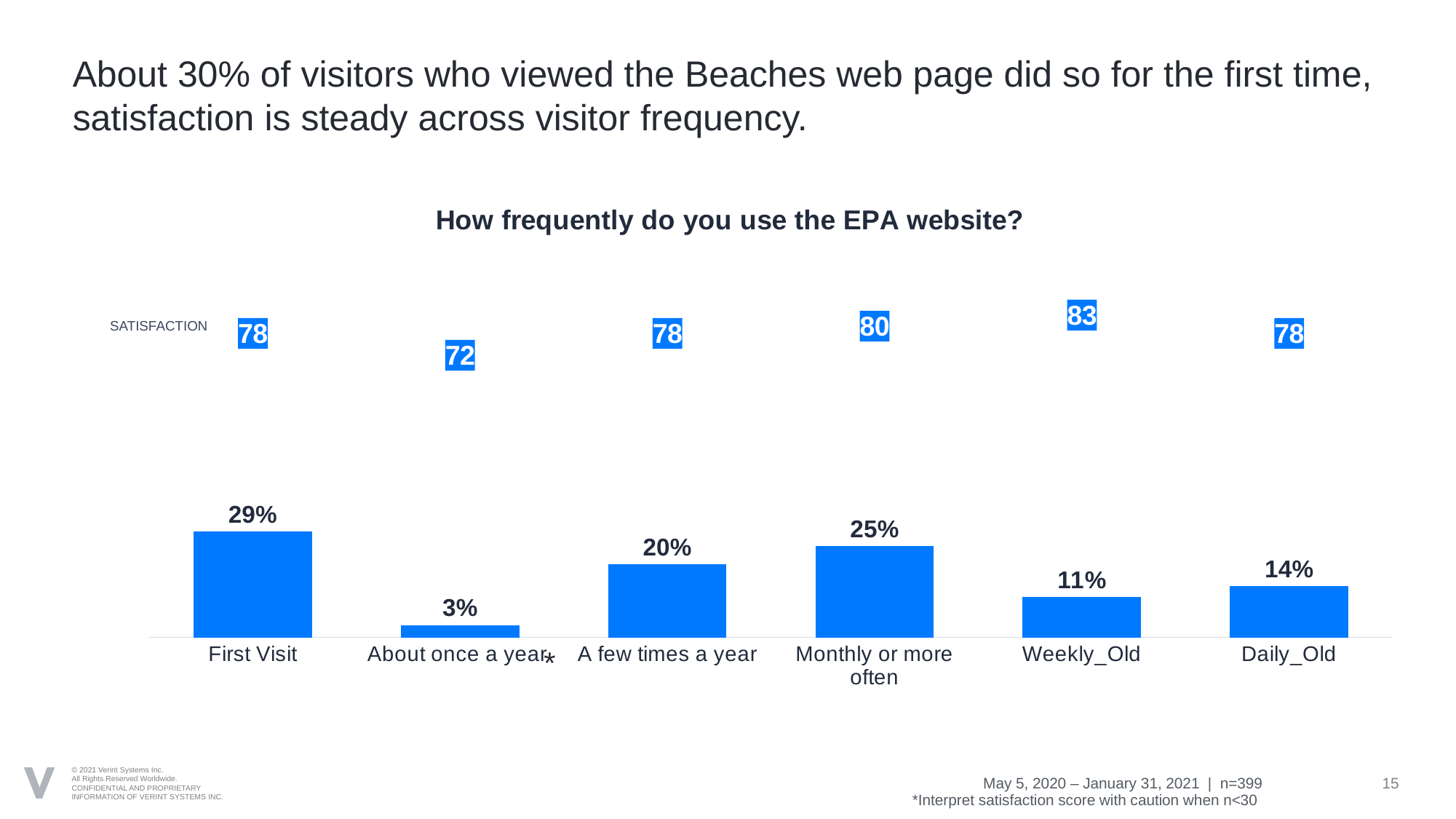
How many visitor frequency categories are shown in the chart? 6 What is the title of the chart? How frequently do you use the EPA website? What is the satisfaction score for visitors who use the site About once a year? 72 What percentage of visitors said it was their First Visit? 29% Which category has the highest satisfaction score? Weekly_Old What is the satisfaction score for Weekly_Old visitors? 83 What percentage of visitors use the EPA website Monthly or more often? 25% What is the difference in percentage points between First Visit and Daily_Old visitors? 15 What type of chart is used to show visitor frequency? Bar chart Which visitor frequency category has the highest percentage of visitors? First Visit Which visitor frequency category has the lowest percentage of visitors? About once a year Which has a larger share of visitors, A few times a year or Weekly_Old? A few times a year